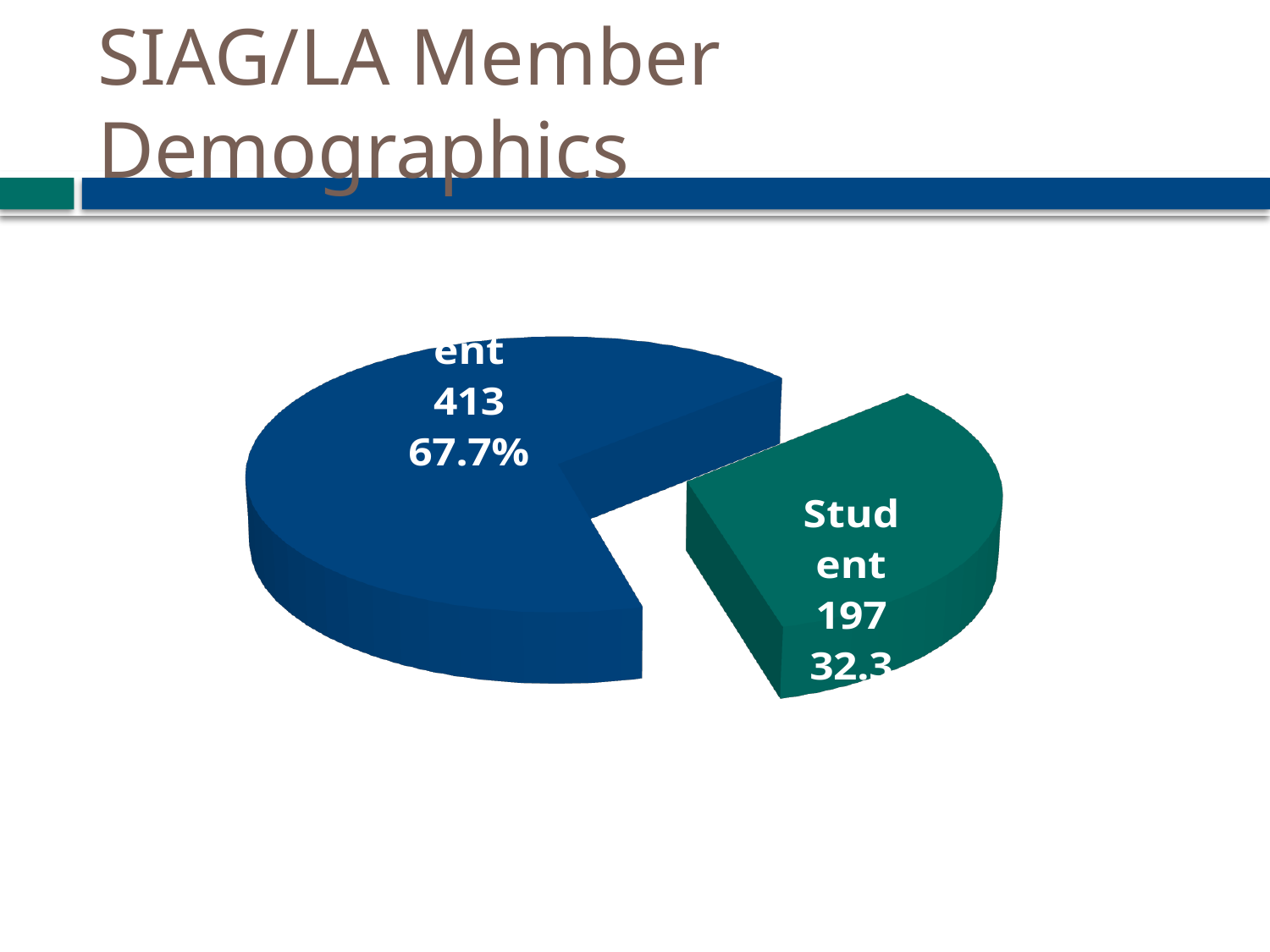
What percentage share is shown on the blue slice? 67.7% How many slices does the pie chart have? 2 Which slice is larger, the blue slice or the Student slice? the blue slice What is the difference between the blue slice value (413) and the Student value (197)? 216 Is the Student slice's share of the pie greater or less than 50%? less What is the title of the slide containing the pie chart? SIAG/LA Member Demographics What is the value shown for the Student slice? 197 What colour is the Student slice? green What is the total of the two slice values shown on the pie chart? 610 What value is shown on the blue slice of the pie chart? 413 What kind of chart is shown on the slide? pie chart